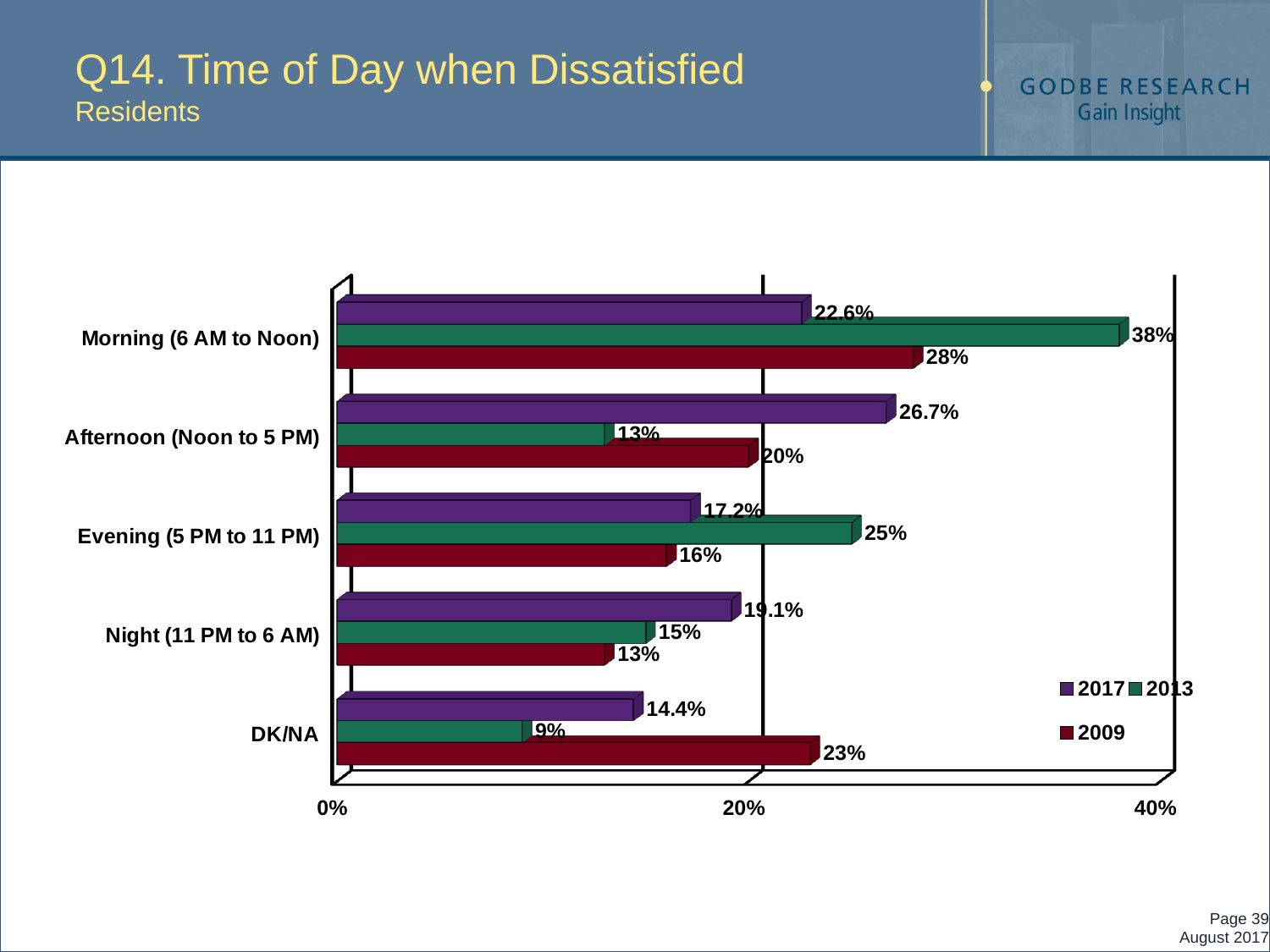
Is the 2013 value for Morning (6 AM to Noon) greater or less than 20%? greater Which year does the purple series represent? 2017 What kind of chart is shown on the slide? Bar chart How many time-of-day categories are shown on the chart? 5 What is the difference between the 2013 and 2009 values for Morning (6 AM to Noon)? 10% Which category has the lowest 2017 value? DK/NA How many series does the legend list? 3 What is the 2017 value for Morning (6 AM to Noon)? 22.6% What is the 2013 value for Afternoon (Noon to 5 PM)? 13% What is the 2009 value for DK/NA? 23% Which is larger for Evening (5 PM to 11 PM): the 2013 value or the 2009 value? 2013 Which category has the highest 2013 value? Morning (6 AM to Noon)